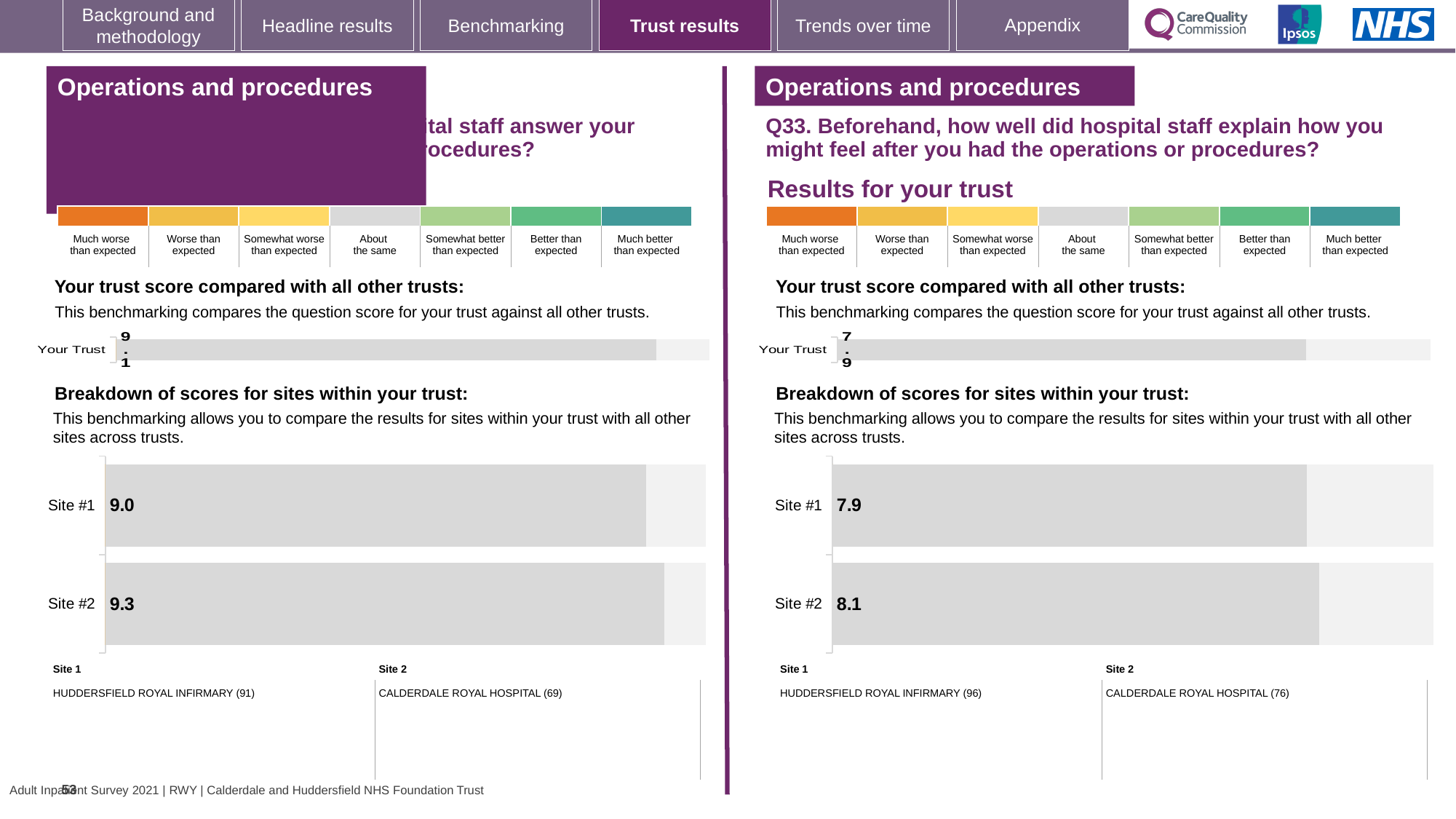
On the left half of the slide, in the site breakdown chart, which site has the higher score? Site #2 On the left half of the slide, in the 'Breakdown of scores for sites within your trust' chart, what is the score for Site #1? 9.0 On the left half of the slide, in the 'Breakdown of scores for sites within your trust' chart, what is the score for Site #2? 9.3 What type of chart is used for the site breakdown on the left half of the slide? Bar chart On the left half of the slide, in the site breakdown chart, what is the difference between the Site #2 and Site #1 scores? 0.3 On the left half of the slide, in the 'Your trust score compared with all other trusts' chart, what is the score for Your Trust? 9.1 On the right half of the slide (Q33), in the site breakdown chart, which site has the lower score? Site #1 On the right half of the slide (Q33), in the 'Breakdown of scores for sites within your trust' chart, what is the score for Site #1? 7.9 How many sites are shown in the site breakdown chart on the right half of the slide (Q33)? 2 On the right half of the slide (Q33), in the 'Breakdown of scores for sites within your trust' chart, what is the score for Site #2? 8.1 On the right half of the slide (Q33), in the site breakdown chart, what is the difference between the Site #2 and Site #1 scores? 0.2 On the right half of the slide (Q33), in the 'Your trust score compared with all other trusts' chart, what is the score for Your Trust? 7.9